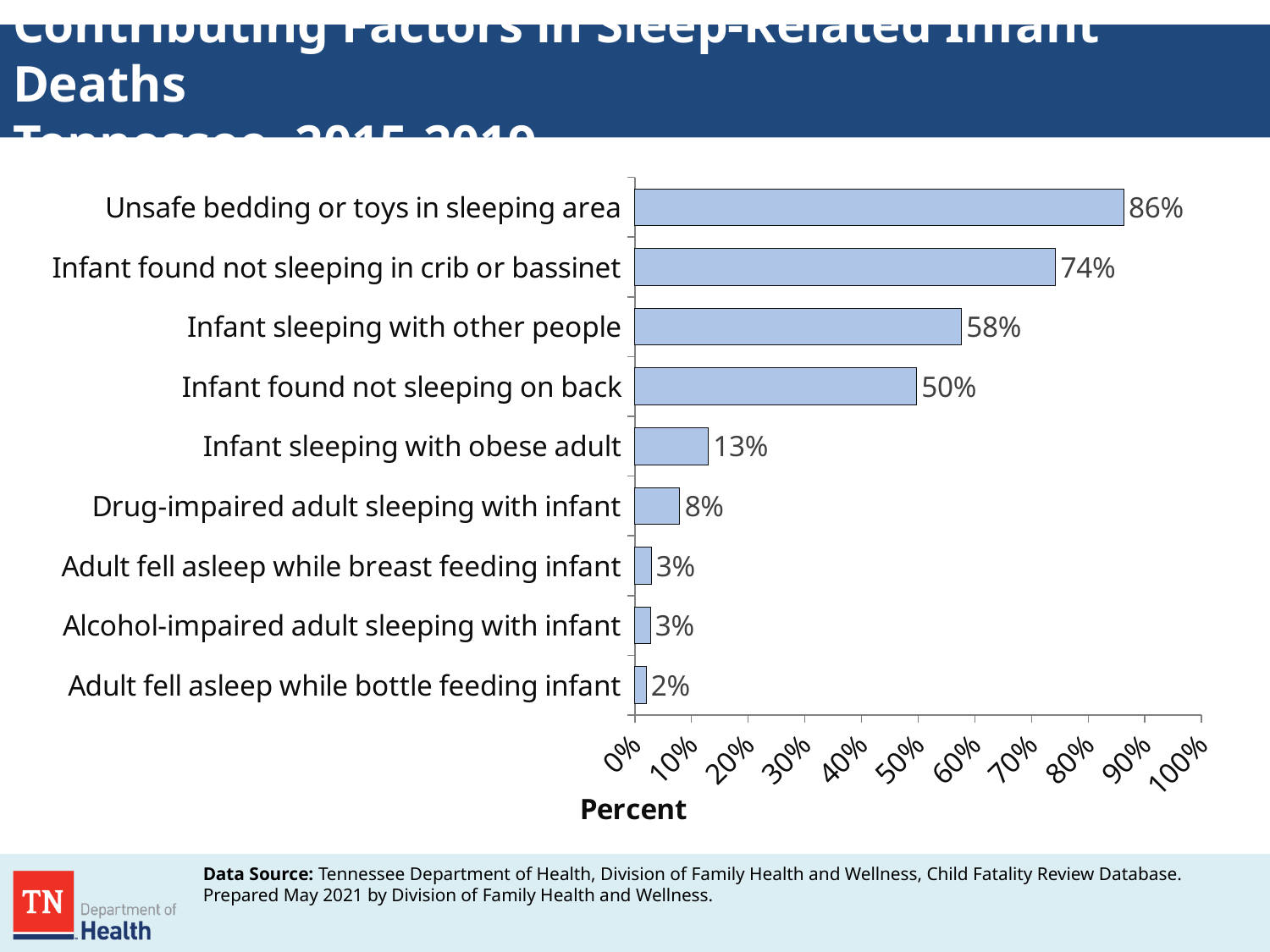
Which contributing factor has the lowest percentage? Adult fell asleep while bottle feeding infant What is the difference between "Infant sleeping with other people" and "Infant sleeping with obese adult"? 45% Which contributing factor has the highest percentage? Unsafe bedding or toys in sleeping area What is the difference between the values for "Unsafe bedding or toys in sleeping area" and "Infant found not sleeping in crib or bassinet"? 12% How many contributing factors are shown in the chart? 9 Which is larger: the value for "Infant sleeping with other people" or "Infant found not sleeping on back"? Infant sleeping with other people What is the label of the horizontal axis? Percent Is the value for "Infant found not sleeping in crib or bassinet" greater or less than 70%? greater What percentage is shown for "Unsafe bedding or toys in sleeping area"? 86% What kind of chart is shown on the slide? Bar chart What percentage is shown for "Drug-impaired adult sleeping with infant"? 8% What is the value for "Infant found not sleeping on back"? 50%